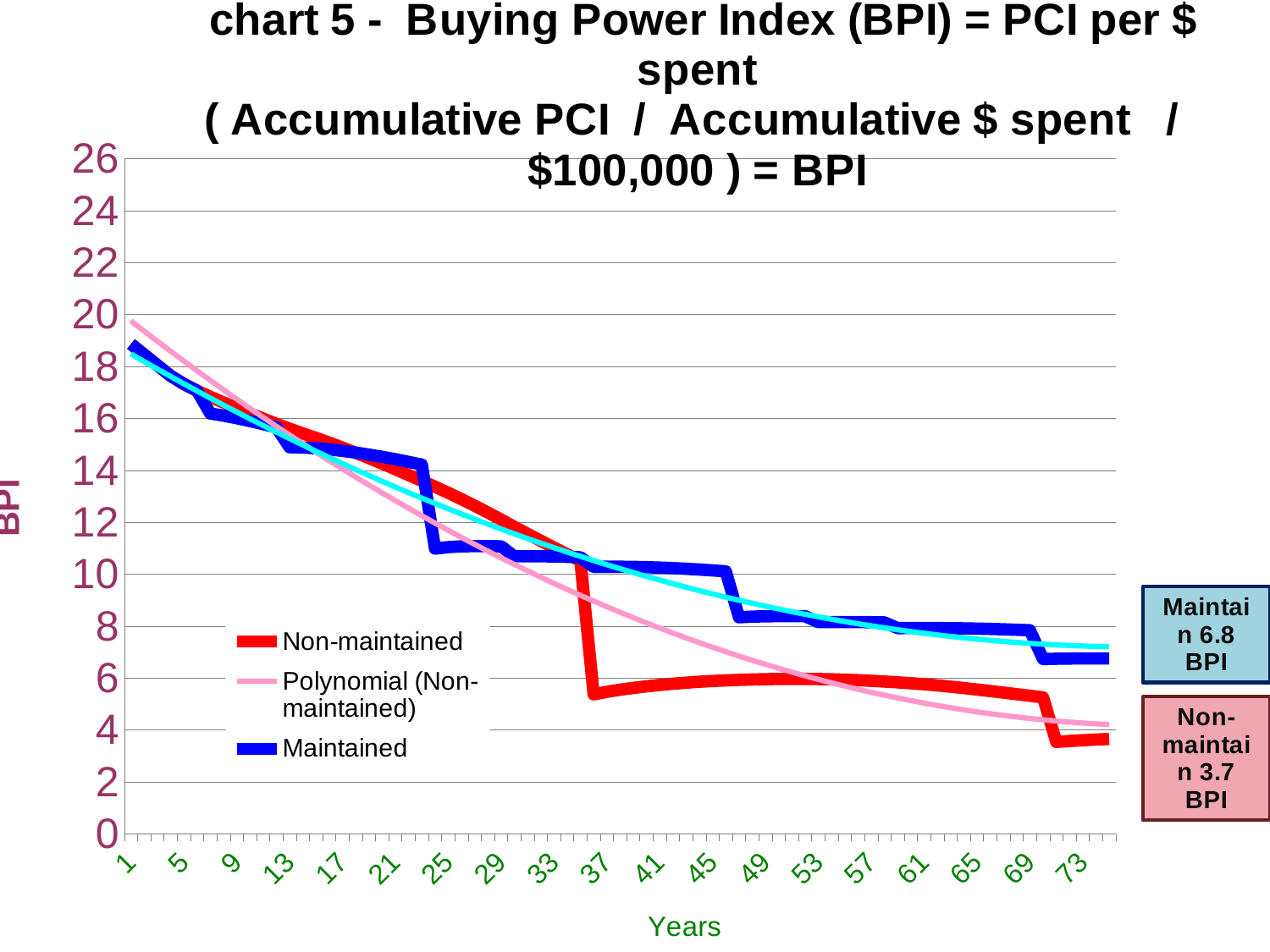
Do the Maintained values rise or fall as the years increase? fall According to the text box on the slide, what is the final BPI for Maintained? 6.8 BPI At year 73, which series has the higher BPI, Maintained or Non-maintained? Maintained What is the label of the x axis? Years Is the Non-maintained value at year 1 greater or less than 16? greater What is the highest value shown on the y axis? 26 Do the Non-maintained values rise or fall as the years increase? fall Is the Non-maintained value at year 37 greater or less than 6? less How many series does the chart's legend list? 3 What kind of chart is shown on the slide? line chart According to the text box on the slide, what is the final BPI for Non-maintained? 3.7 BPI Is the Maintained value at year 25 greater or less than 12? less